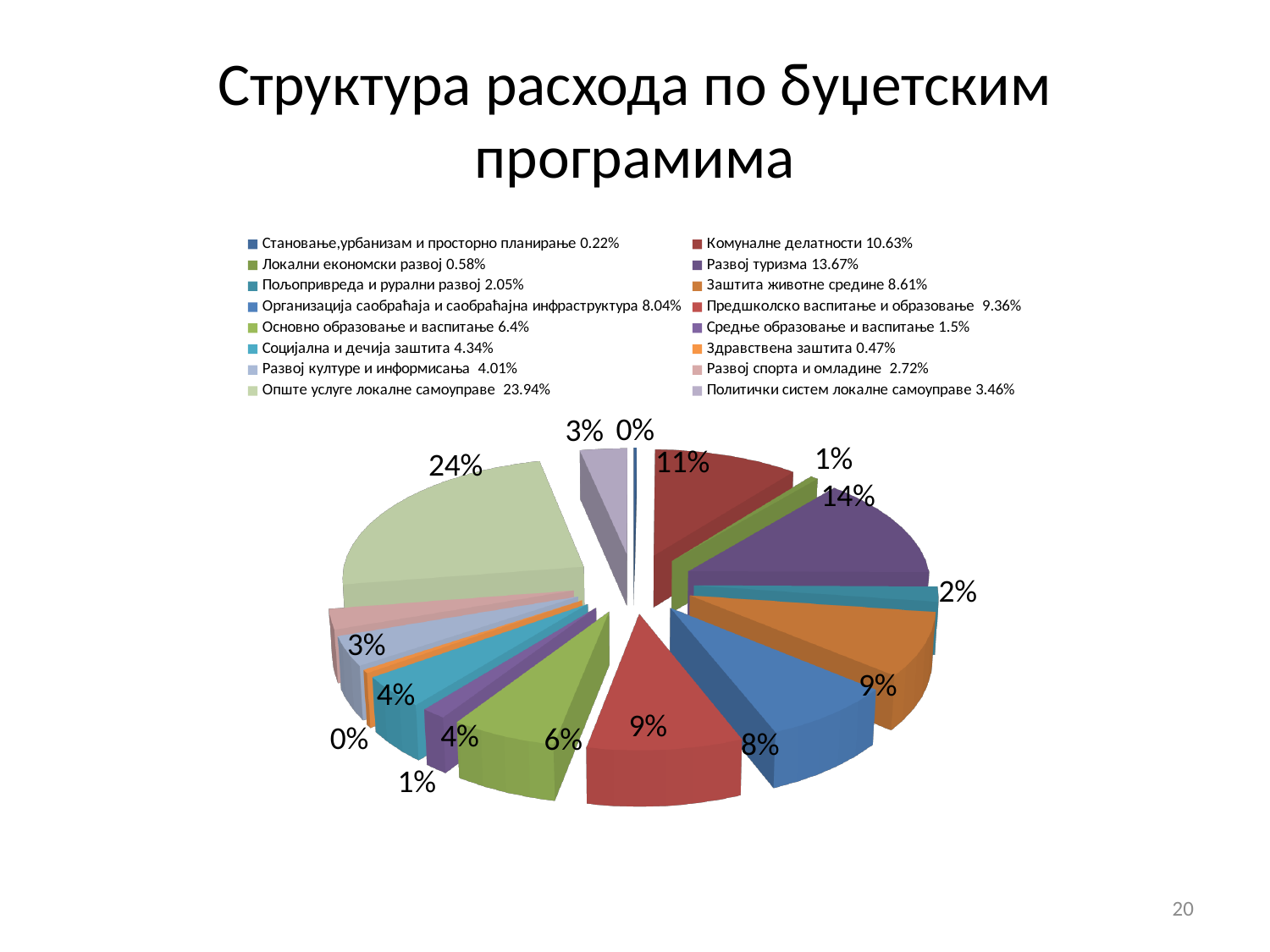
How many categories does the legend of the pie chart list? 16 Which category has the largest share of the pie? Опште услуге локалне самоуправе Which has a larger share: Заштита животне средине or Организација саобраћаја и саобраћајна инфраструктура? Заштита животне средине What is the difference in percentage points between Развој туризма and Комуналне делатности according to the legend? 3.04% What is the title of the slide containing the chart? Структура расхода по буџетским програмима What percentage is shown in the legend for Предшколско васпитање и образовање? 9.36% What percentage is shown in the legend for Развој туризма? 13.67% Which category has the smallest share of the pie? Становање,урбанизам и просторно планирање What is the rounded percentage label shown on the pie slice for Опште услуге локалне самоуправе? 24% What percentage is shown in the legend for Комуналне делатности? 10.63% What kind of chart is shown on the slide? pie chart What percentage is shown in the legend for Социјална и дечија заштита? 4.34%